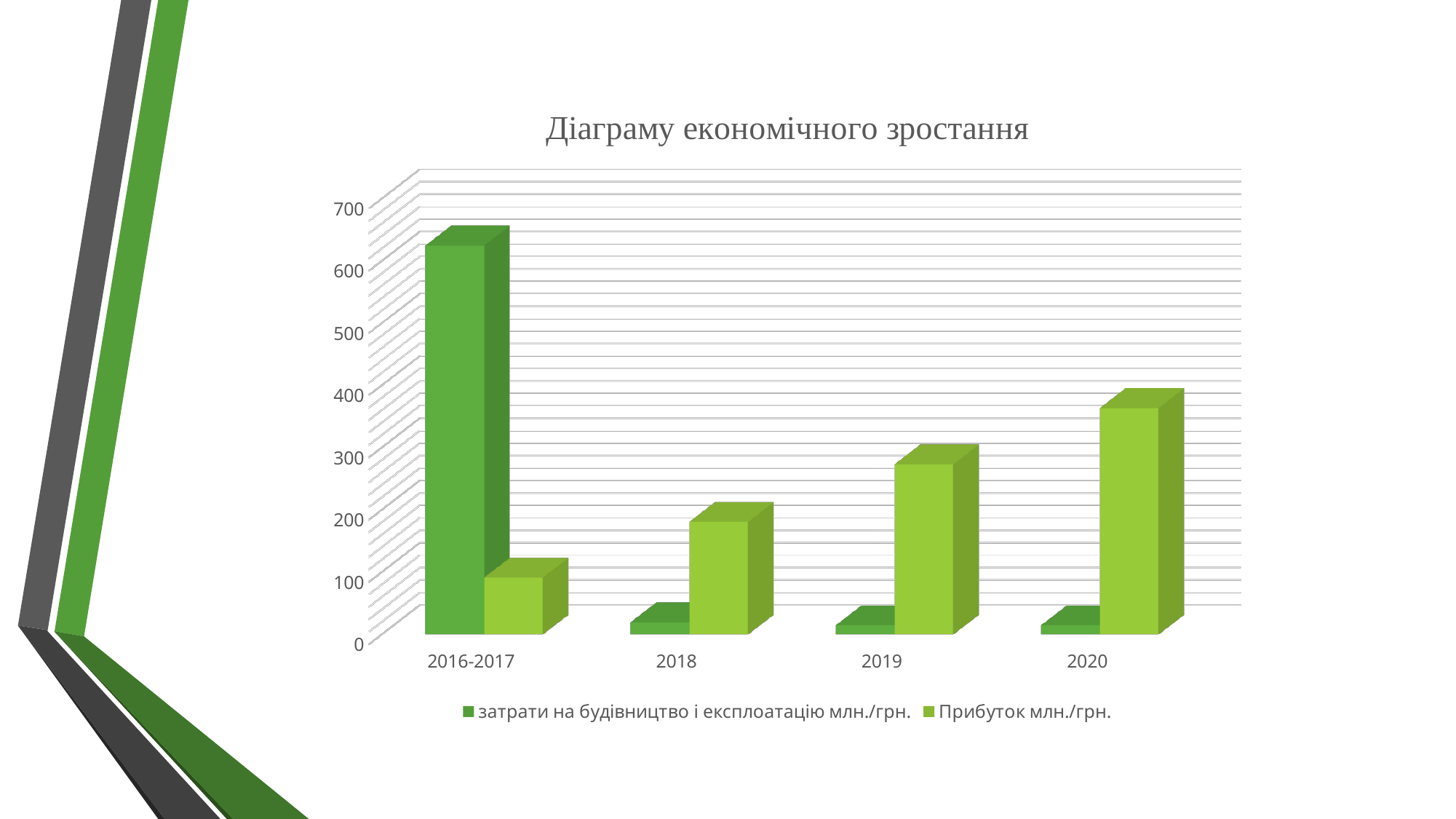
How many categories are shown on the x axis? 4 Does the value for 'Прибуток млн./грн.' rise or fall from 2016-2017 to 2020? rise In which category is the value for 'Прибуток млн./грн.' highest? 2020 How many series does the legend list? 2 What is the title of the chart? Діаграму економічного зростання In which category is the value for 'Прибуток млн./грн.' lowest? 2016-2017 What kind of chart is shown on the slide? bar chart Is the value for 'затрати на будівництво і експлоатацію млн./грн.' in 2016-2017 greater or less than 500? greater In 2020, which series has the larger value: 'затрати на будівництво і експлоатацію млн./грн.' or 'Прибуток млн./грн.'? Прибуток млн./грн. Is the value for 'затрати на будівництво і експлоатацію млн./грн.' in 2018 greater or less than 100? less Is the value for 'Прибуток млн./грн.' in 2020 greater or less than 300? greater In which category is the value for 'затрати на будівництво і експлоатацію млн./грн.' highest? 2016-2017